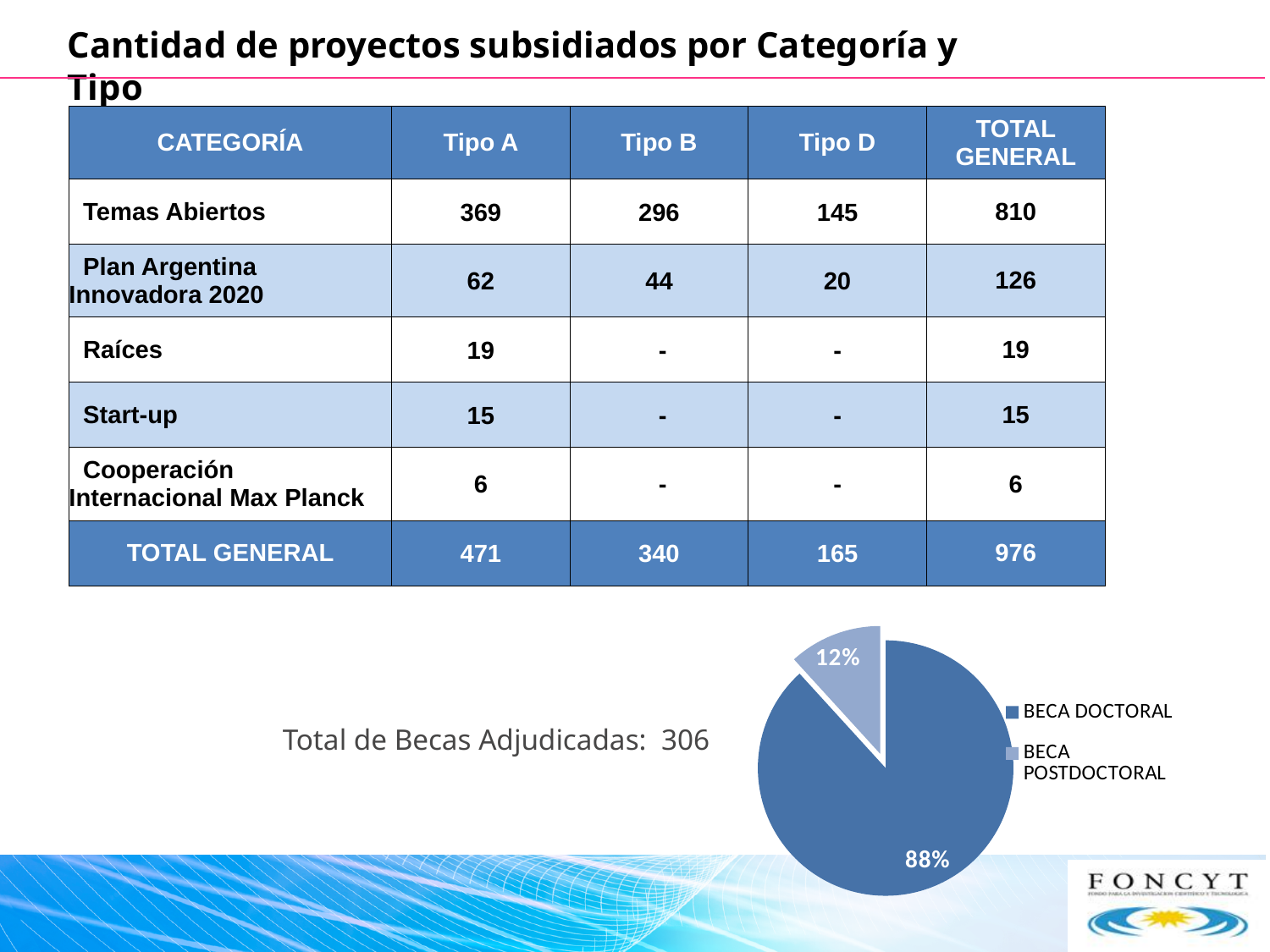
How many slices does the pie chart have? 2 Which slice of the pie chart is the largest? BECA DOCTORAL What kind of chart is shown at the bottom right of the slide? pie chart How many entries does the pie chart's legend list? 2 In the pie chart, what share does BECA POSTDOCTORAL have? 12% In the pie chart, which is larger: BECA DOCTORAL or BECA POSTDOCTORAL? BECA DOCTORAL What are the two legend entries of the pie chart? BECA DOCTORAL and BECA POSTDOCTORAL Which slice of the pie chart is the smallest? BECA POSTDOCTORAL In the pie chart, what is the difference in percentage points between the BECA DOCTORAL and BECA POSTDOCTORAL shares? 76 percentage points In the pie chart, what share does BECA DOCTORAL have? 88% In the pie chart, which slice is shown in the lighter blue colour? BECA POSTDOCTORAL